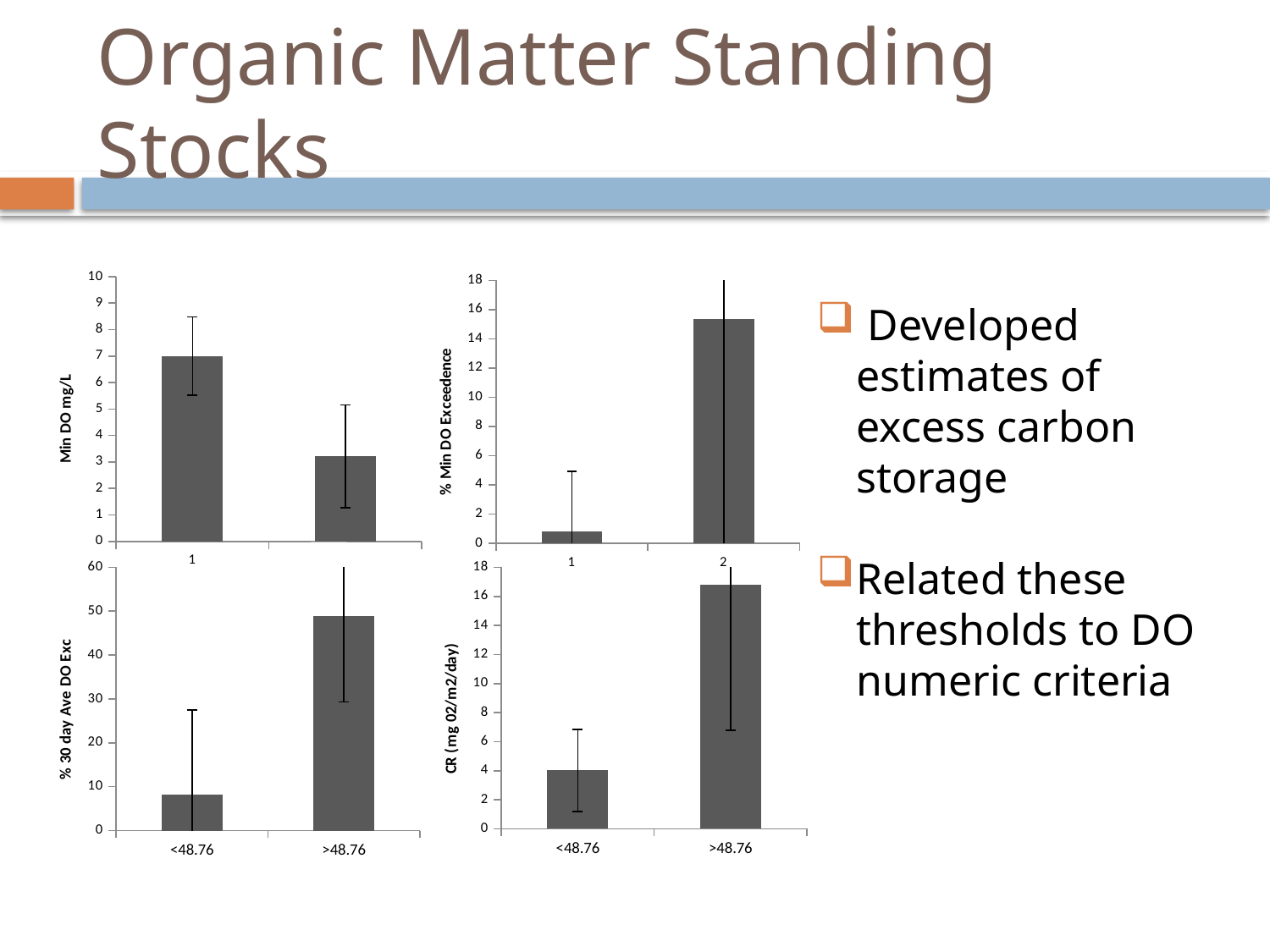
In the bottom-right chart ('CR (mg O2/m2/day)'), is the value for >48.76 greater or less than 14? greater What kind of chart is the top-left chart with the y-axis 'Min DO mg/L'? bar chart In the bottom-right chart ('CR (mg O2/m2/day)'), which category has the higher bar, <48.76 or >48.76? >48.76 In the bottom-left chart ('% 30 day Ave DO Exc'), which category has the lowest bar? <48.76 In the bottom-left chart ('% 30 day Ave DO Exc'), is the value for <48.76 greater or less than 10? less In the top-right chart ('% Min DO Exceedence'), which category has the highest bar? 2 In the bottom-right chart ('CR (mg O2/m2/day)'), is the value for <48.76 greater or less than 6? less In the bottom-left chart ('% 30 day Ave DO Exc'), how many bars are plotted? 2 What is the y-axis title of the bottom-right chart? CR (mg O2/m2/day)